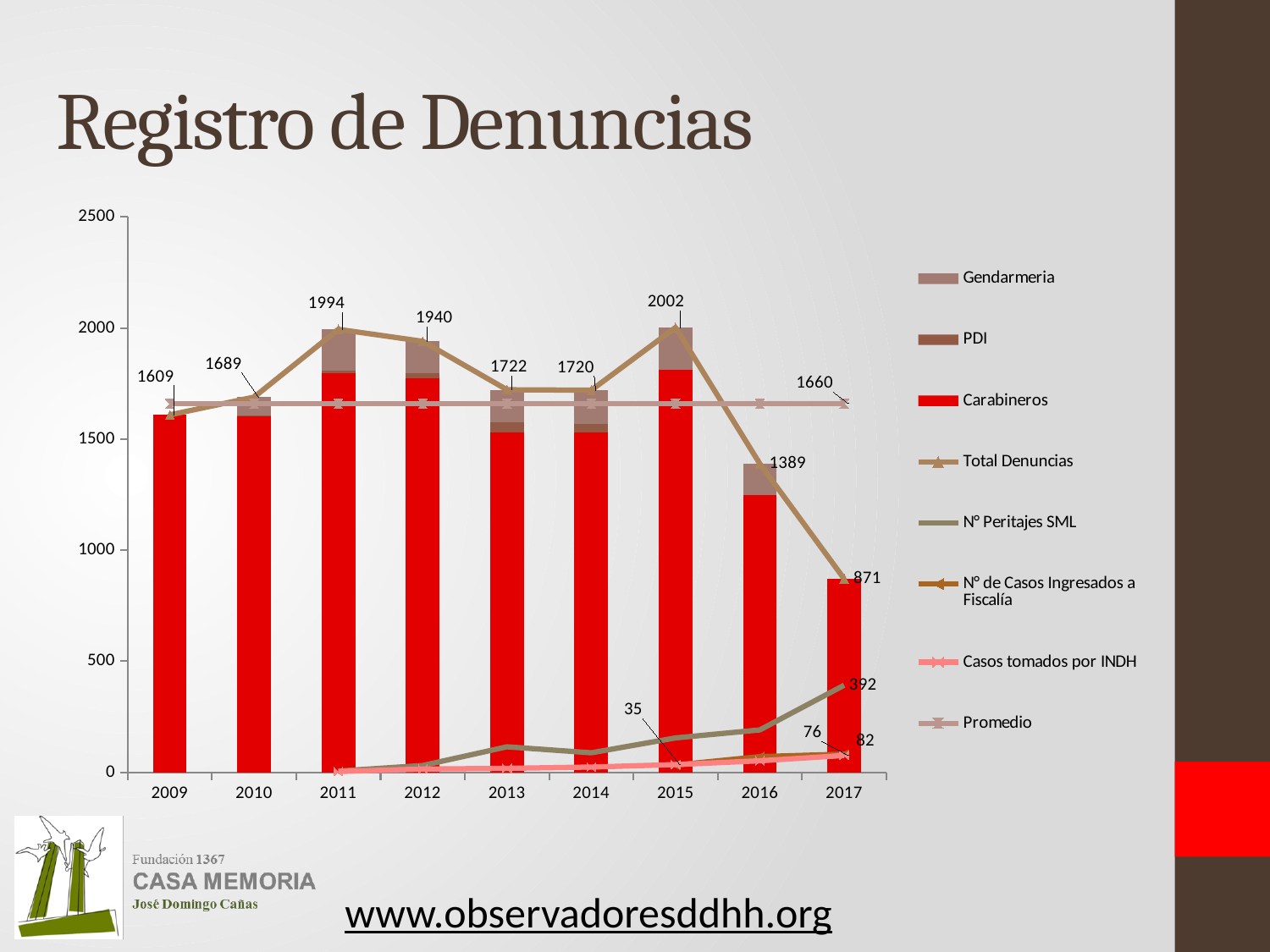
Which year has a higher Total Denuncias, 2011 or 2012? 2011 Is the Carabineros value for 2017 greater or less than 1000? less What is the title of the chart on the slide? Registro de Denuncias What is the value of Total Denuncias in 2011? 1994 How many years are shown on the x axis? 9 How many series does the legend list? 8 What is the value of the Promedio line? 1660 In which year is Total Denuncias lowest? 2017 What is the difference between Total Denuncias in 2015 and in 2017? 1131 What is the value of Nº Peritajes SML in 2017? 392 In which year is Total Denuncias highest? 2015 What kind of chart is shown on the slide? A combined bar and line chart